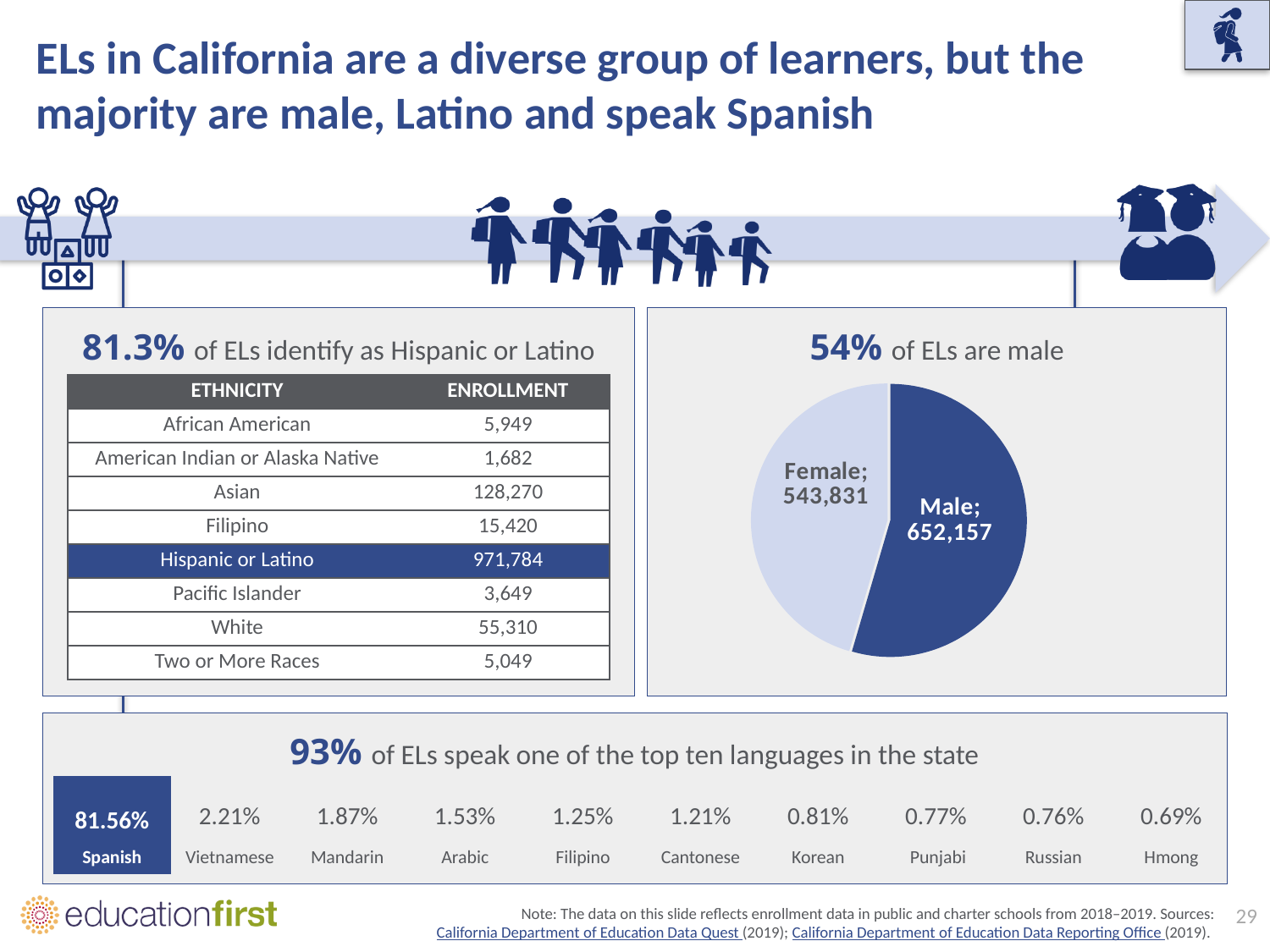
What kind of chart is shown under the heading '54% of ELs are male'? pie chart In the pie chart, which slice is coloured dark blue? Male In the pie chart, which slice is the largest? Male According to the pie chart heading, what share of ELs are male? 54% In the pie chart, what is the difference between the Male and Female values? 108,326 In the pie chart, what is the value for Male? 652,157 In the pie chart, what is the value for Female? 543,831 In the pie chart, which is larger, the Male value or the Female value? Male How many slices does the pie chart have? 2 What is the heading above the pie chart? 54% of ELs are male In the pie chart, what is the total of the Male and Female values? 1,195,988 In the pie chart, which slice is the smallest? Female